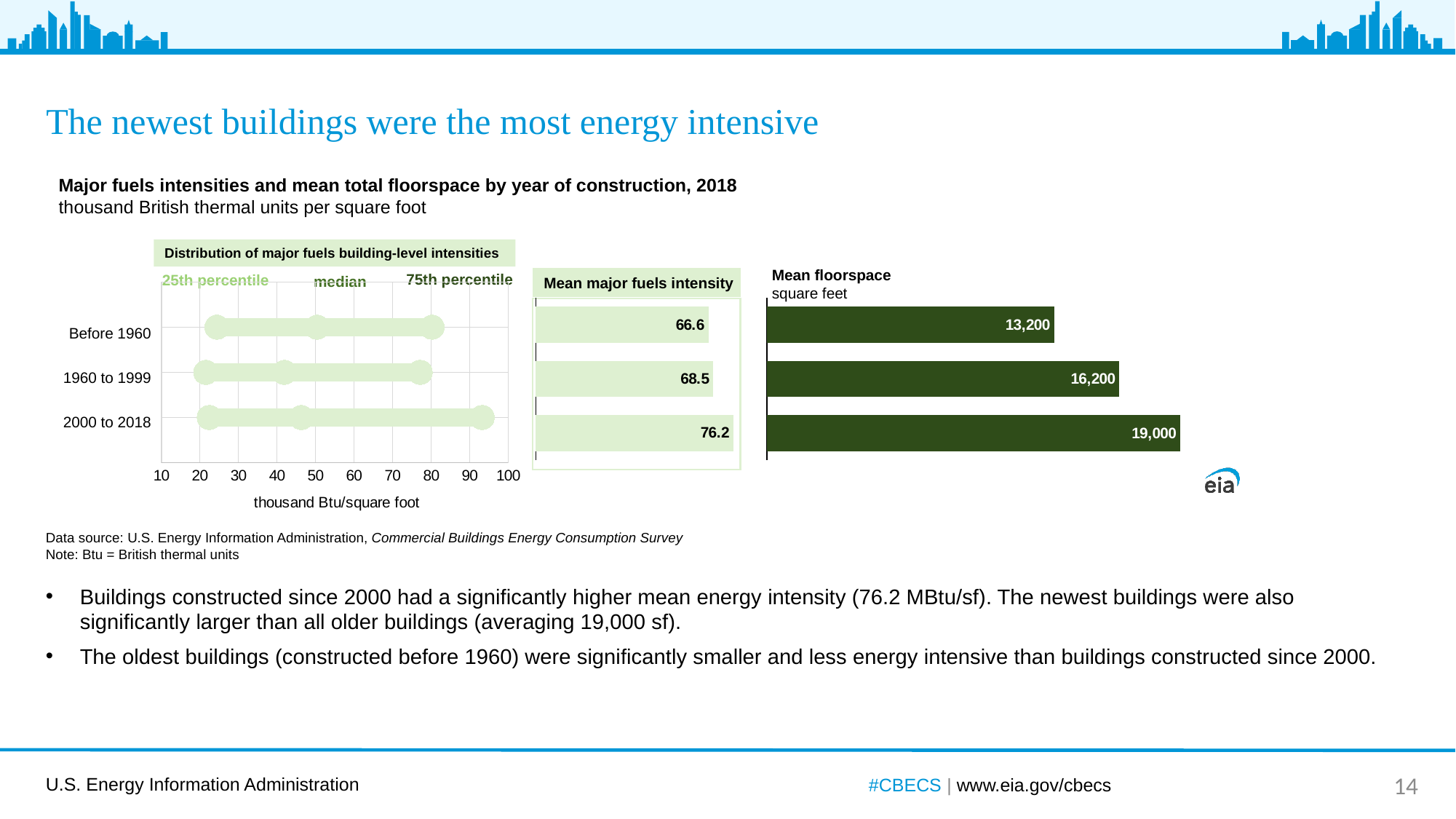
In the Mean floorspace chart, which construction period has the largest mean floorspace? 2000 to 2018 In the Mean floorspace chart, what is the value for buildings constructed 1960 to 1999? 16,200 In the Mean floorspace chart, what is the difference between the values for 2000 to 2018 and Before 1960? 5,800 In the Distribution of major fuels building-level intensities chart, is the median for 1960 to 1999 greater or less than 50? less In the Mean major fuels intensity chart, which construction period has the lowest mean intensity? Before 1960 In the Mean major fuels intensity chart, what is the value for buildings constructed before 1960? 66.6 What kind of chart is the Mean floorspace chart? bar chart How many construction periods are shown in the Mean floorspace chart? 3 In the Mean major fuels intensity chart, which is larger: the value for 1960 to 1999 or the value for Before 1960? 1960 to 1999 In the Mean major fuels intensity chart, what is the value for buildings constructed 2000 to 2018? 76.2 In the Mean major fuels intensity chart, what is the difference between the values for 2000 to 2018 and Before 1960? 9.6 In the Distribution of major fuels building-level intensities chart, is the 75th percentile for 2000 to 2018 greater or less than 80? greater